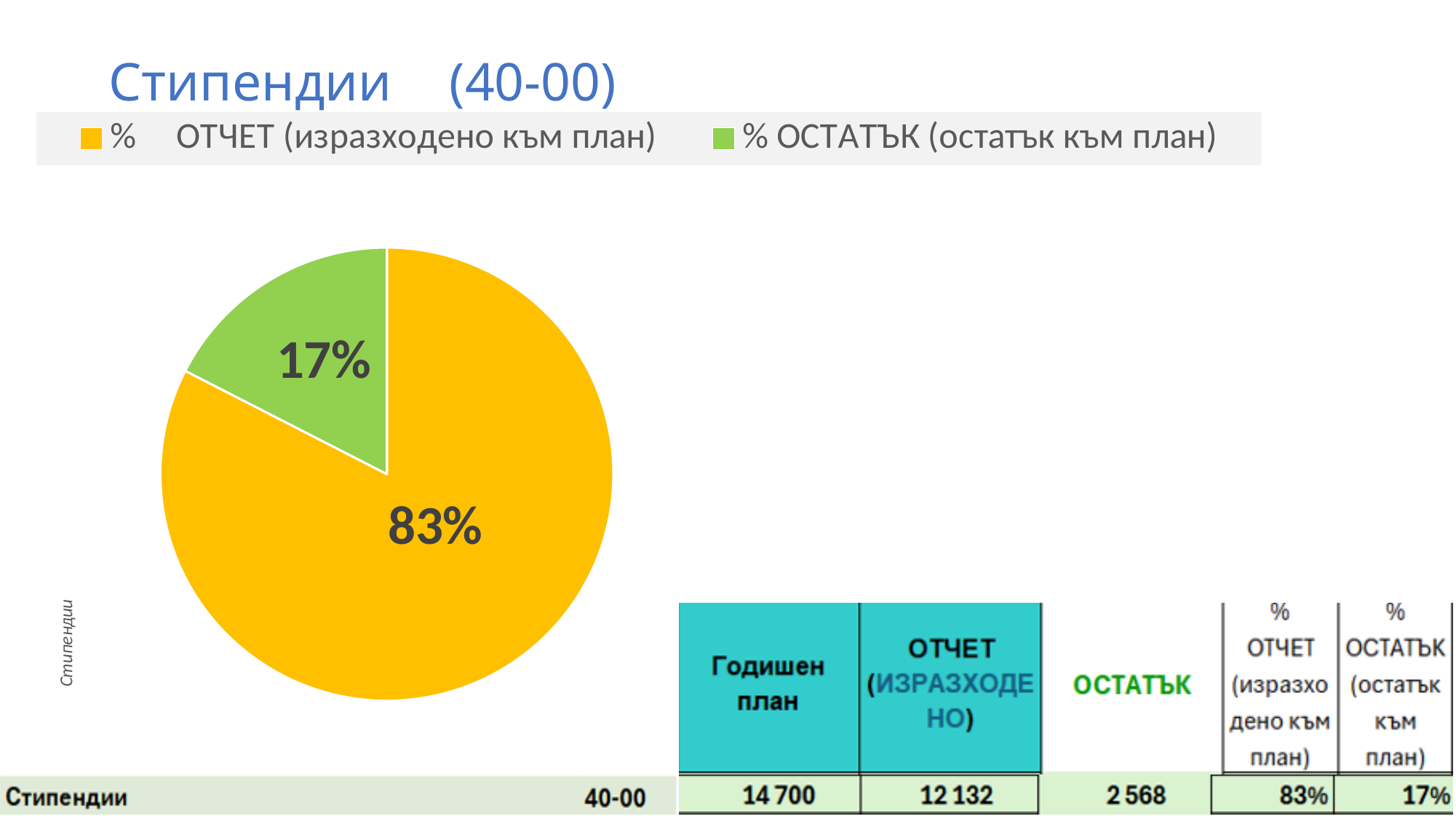
What is the value of the ОТЧЕТ slice as printed on the pie? 83% What share of the pie does the "% ОТЧЕТ (изразходено към план)" slice represent? 83% What kind of chart is shown on the slide? pie chart What is the difference in percentage points between the ОТЧЕТ slice and the ОСТАТЪК slice? 66 What share of the pie does the "% ОСТАТЪК (остатък към план)" slice represent? 17% Which is larger: the ОТЧЕТ slice or the ОСТАТЪК slice? ОТЧЕТ Which slice of the pie is the smallest? % ОСТАТЪК (остатък към план) What colour is the "% ОСТАТЪК (остатък към план)" slice? green How many entries does the legend list? 2 How many slices does the pie chart have? 2 Which slice of the pie is the largest? % ОТЧЕТ (изразходено към план) What is the title of the chart? Стипендии